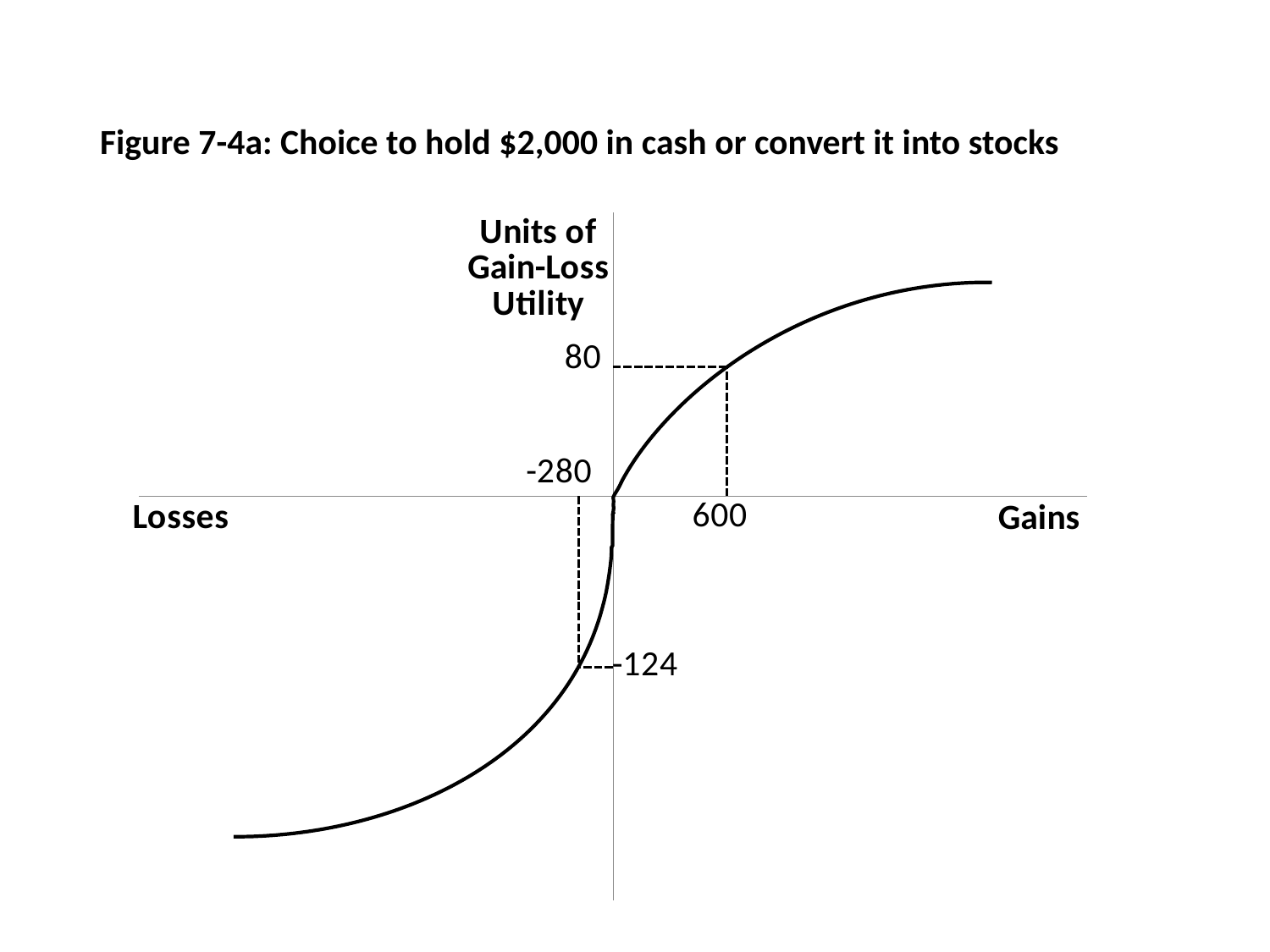
What loss amount is marked on the horizontal axis with a dashed line to the curve? -280 What gain amount is marked on the horizontal axis with a dashed line to the curve? 600 What kind of chart is shown on the slide? line chart What is the gain-loss utility shown for a loss of -280? -124 What is the gain-loss utility shown for a gain of 600? 80 Is the utility for a gain of 600 greater or less than 0? greater What is the title of the figure on the slide? Figure 7-4a: Choice to hold $2,000 in cash or convert it into stocks Which is larger in absolute size: the utility of 80 for a gain of 600 or the utility of -124 for a loss of -280? -124 for a loss of -280 What is the difference between the utility at a gain of 600 (80) and the utility at a loss of -280 (-124)? 204 What is the label of the vertical axis? Units of Gain-Loss Utility Does the curve rise or fall as you move from losses to gains along the horizontal axis? rise